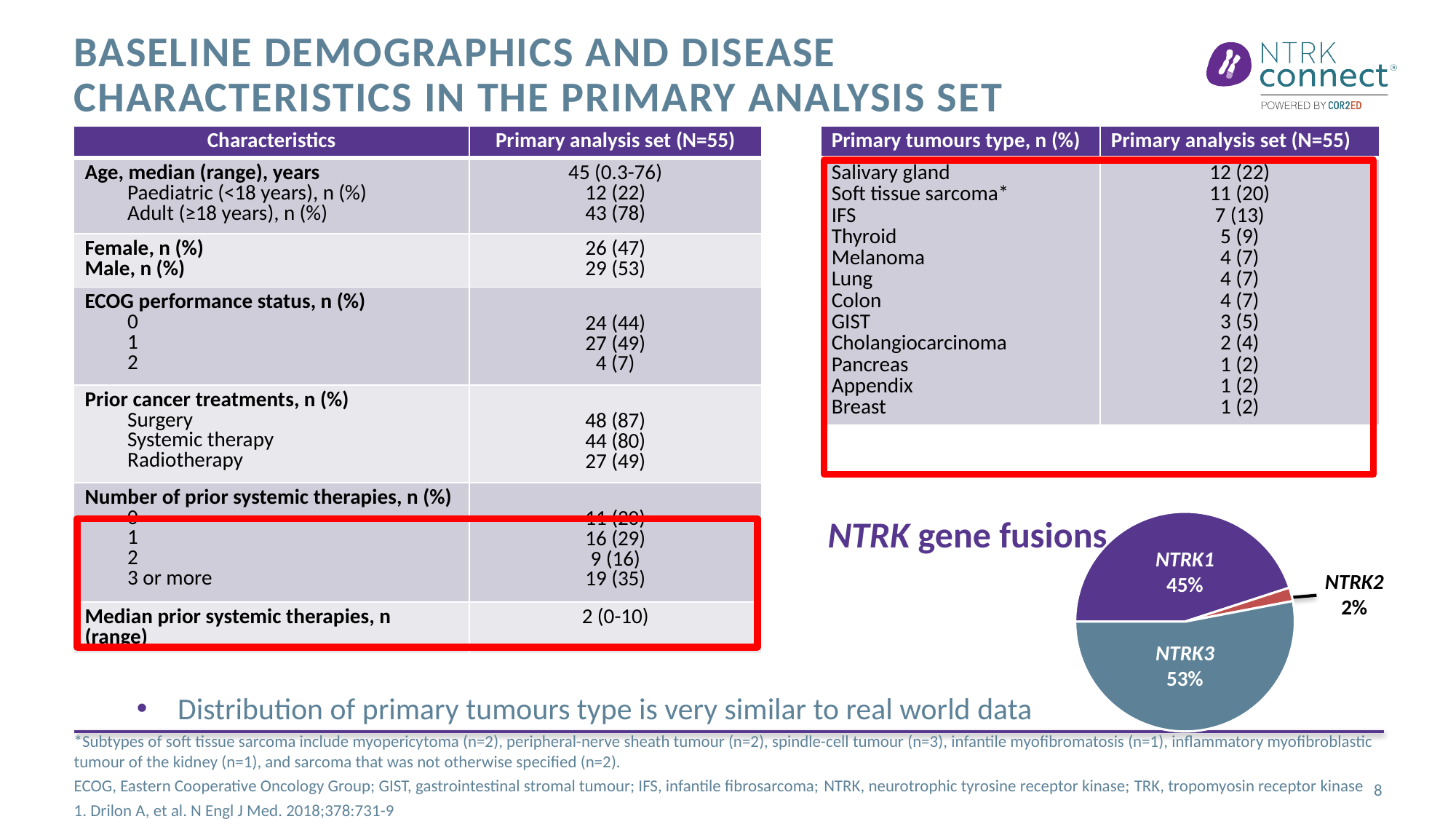
In the NTRK gene fusions pie chart, what is the difference in percentage points between NTRK3 and NTRK1? 8 What kind of chart is the NTRK gene fusions chart? pie chart In the NTRK gene fusions pie chart, what share is NTRK2? 2% What is the title of the pie chart on the slide? NTRK gene fusions In the NTRK gene fusions pie chart, which gene fusion has the smallest slice? NTRK2 In the NTRK gene fusions pie chart, which gene fusion has the largest slice? NTRK3 In the NTRK gene fusions pie chart, what share is NTRK1? 45% In the NTRK gene fusions pie chart, what share is NTRK3? 53% In the NTRK gene fusions pie chart, what colour is the NTRK1 slice? purple In the NTRK gene fusions pie chart, which is larger, NTRK1 or NTRK3? NTRK3 In the NTRK gene fusions pie chart, what is the difference in percentage points between NTRK1 and NTRK2? 43 In the NTRK gene fusions pie chart, how many slices are there? 3